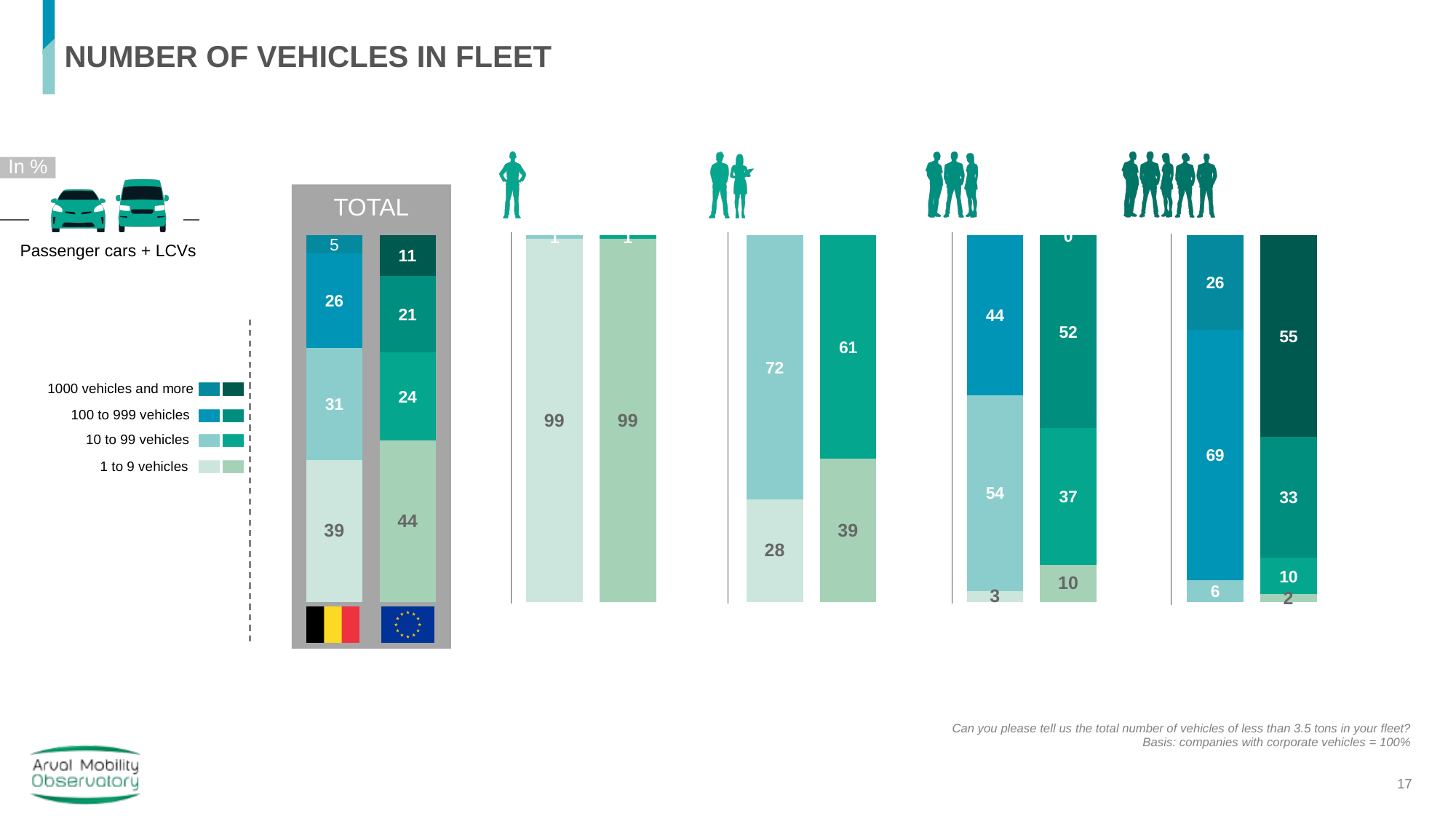
In the rightmost company-size group, what is the European share for 1000 vehicles and more? 55 In the rightmost company-size group, what is the Belgian share for 100 to 999 vehicles? 69 How many fleet-size categories does the legend list? 4 In the TOTAL chart, what is the difference between the European and Belgian shares for 1 to 9 vehicles? 5 In the TOTAL chart, which fleet-size category has the highest share for Europe? 1 to 9 vehicles In the TOTAL chart, which is larger: the Belgian share for 100 to 999 vehicles or the European share for 100 to 999 vehicles? Belgian (26) In the TOTAL chart, what percentage of Belgian companies have 1 to 9 vehicles? 39 In the second company-size group from the left, what is the Belgian share for 10 to 99 vehicles? 72 What type of chart is used on this slide? Stacked bar chart In the TOTAL chart, which fleet-size category has the lowest share for Belgium? 1000 vehicles and more In the second company-size group from the left, what is the European share for 1 to 9 vehicles? 39 In the TOTAL chart, what percentage of European companies have 1000 vehicles and more? 11